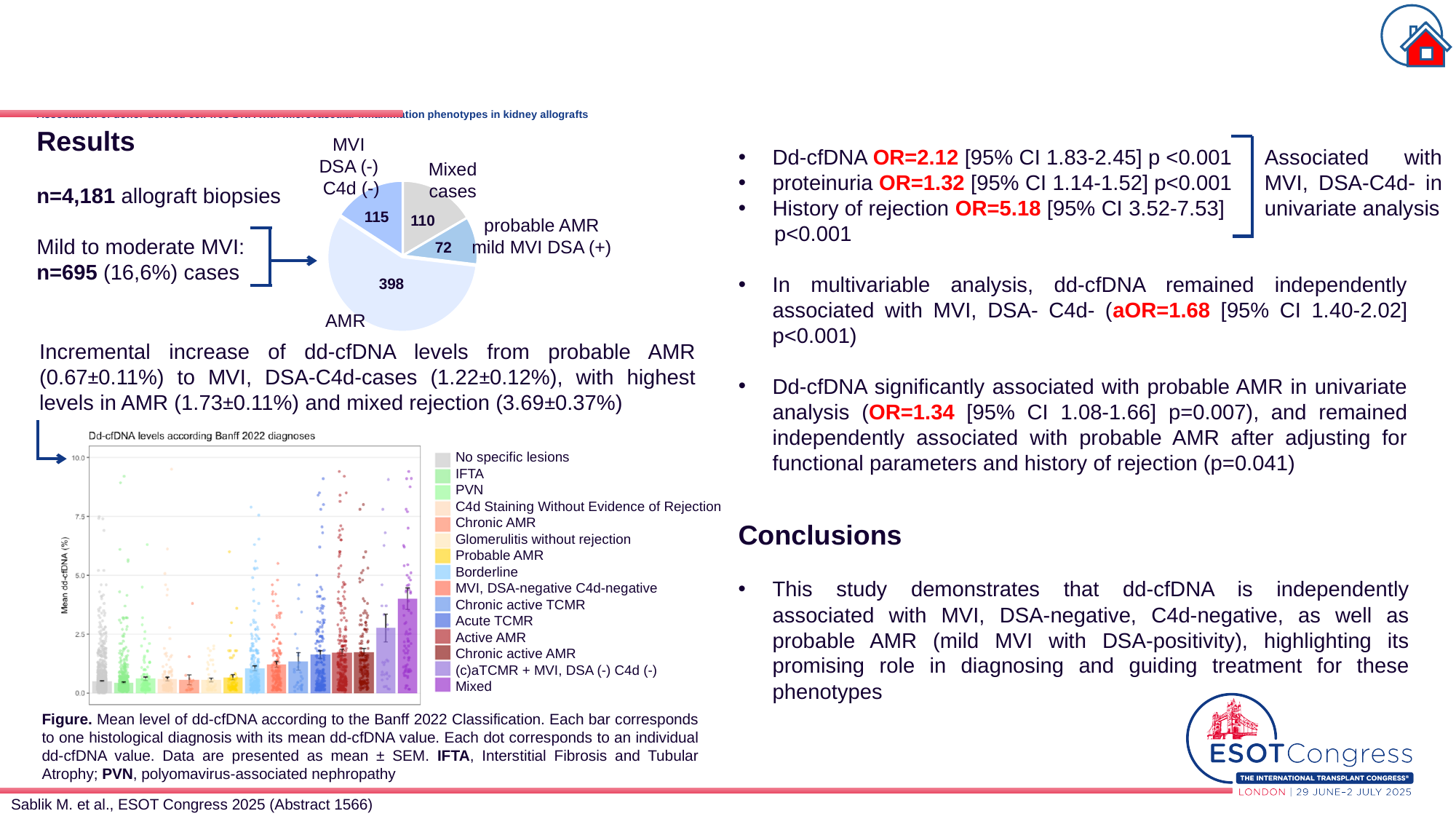
In the chart titled 'Dd-cfDNA levels according Banff 2022 diagnoses', which diagnosis has the highest mean dd-cfDNA bar? Mixed In the chart titled 'Dd-cfDNA levels according Banff 2022 diagnoses', how many diagnoses does the legend list? 15 In the pie chart, what is the total of all four slices? 695 In the pie chart, what is the difference between the AMR slice and the MVI DSA (-) C4d (-) slice? 283 In the pie chart, how many cases are in the probable AMR (mild MVI DSA (+)) slice? 72 In the pie chart, how many cases are in the AMR slice? 398 In the pie chart, how many slices are there? 4 In the chart titled 'Dd-cfDNA levels according Banff 2022 diagnoses', is the mean bar for No specific lesions greater or less than 2.5? less In the chart titled 'Dd-cfDNA levels according Banff 2022 diagnoses', is the mean bar for Mixed greater or less than 2.5? greater In the pie chart, which slice has the smallest number of cases? probable AMR mild MVI DSA (+) In the pie chart, how many cases are in the Mixed cases slice? 110 In the pie chart, which slice has the largest number of cases? AMR